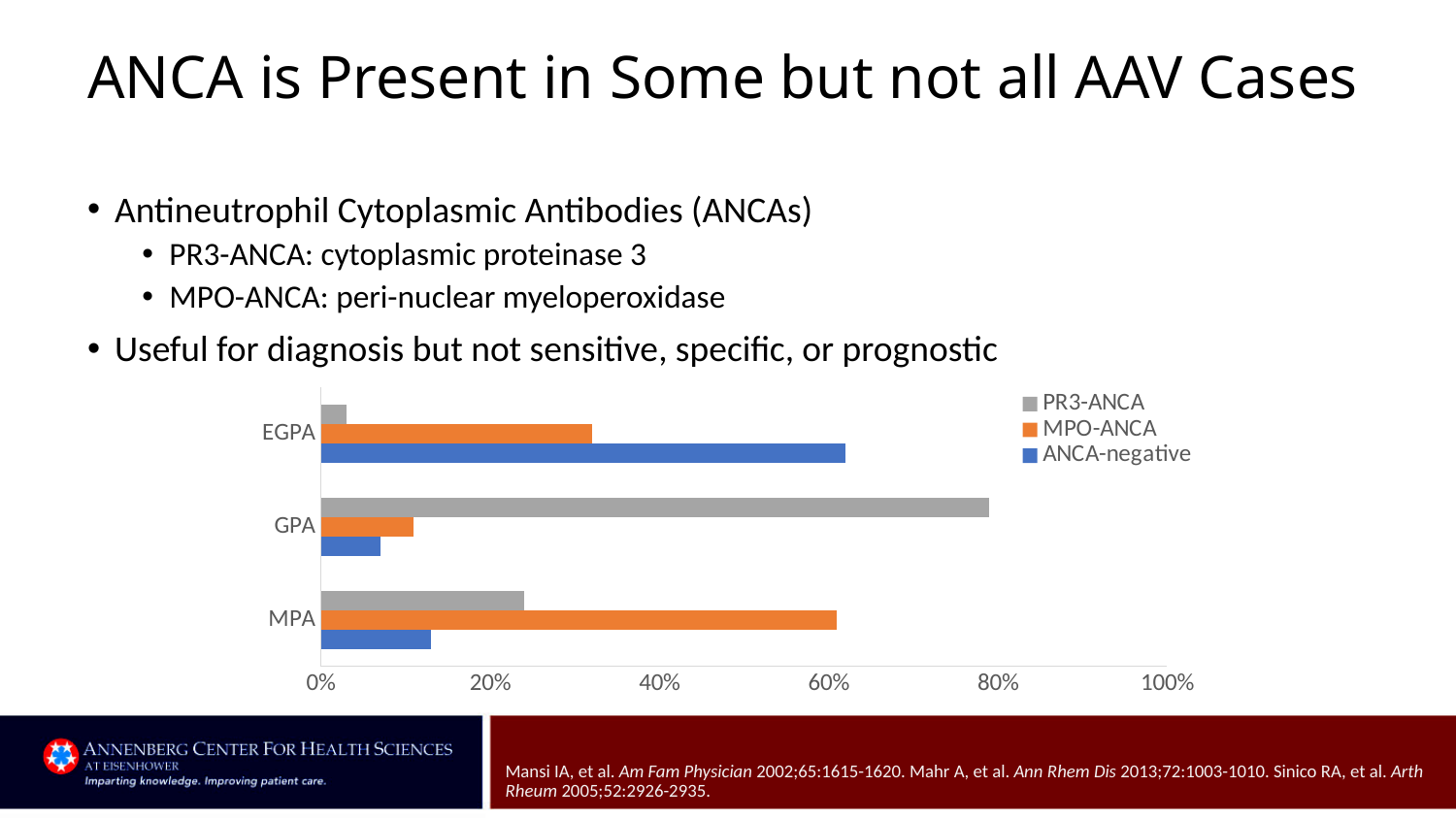
Which category has the highest ANCA-negative value? EGPA Which category has the highest MPO-ANCA value? MPA Is the ANCA-negative value for EGPA greater or less than 40%? greater Which category has the lowest PR3-ANCA value? EGPA For EGPA, which is larger: the MPO-ANCA value or the ANCA-negative value? ANCA-negative How many series does the chart's legend list? 3 Which legend entry is shown in orange? MPO-ANCA Is the PR3-ANCA value for GPA greater or less than 60%? greater Is the MPO-ANCA value for GPA greater or less than 20%? less What kind of chart is shown on the slide? bar chart Which category has the highest PR3-ANCA value? GPA How many categories are shown on the chart's vertical axis? 3